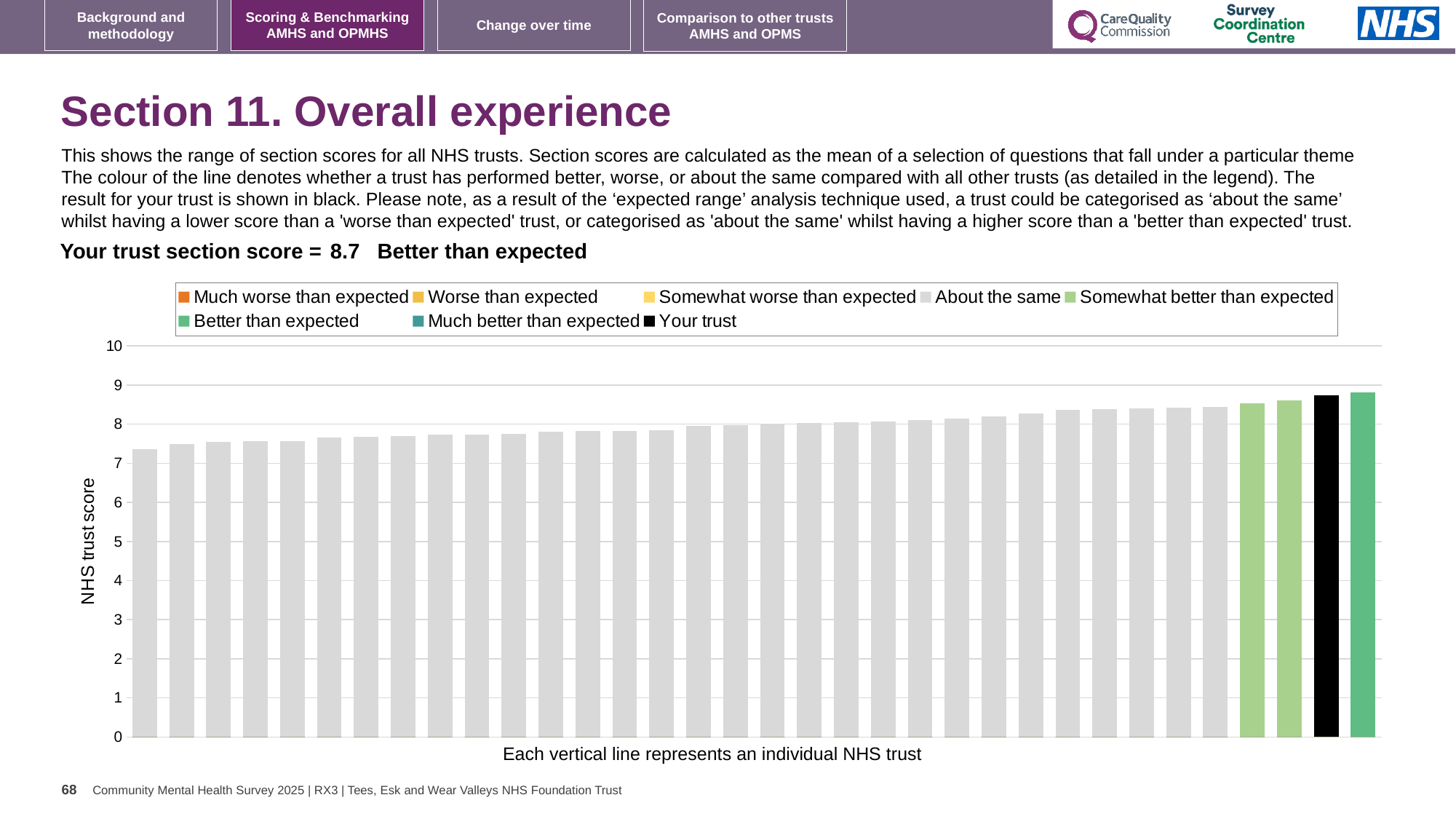
How many bars are coloured light green (somewhat better than expected)? 2 Do the bar values rise or fall from left to right across the chart? rise Is the value of the leftmost (lowest) bar greater or less than 7? greater How is your trust's section score categorised on the slide? Better than expected What colour is the bar representing your trust? black Is your trust's section score greater or less than 8? greater Is the value of the leftmost (lowest) bar greater or less than 8? less How many entries does the chart legend list? 8 What is the section score for your trust shown on the slide? 8.7 What is the label on the vertical axis of the chart? NHS trust score What kind of chart is shown on the slide? bar chart